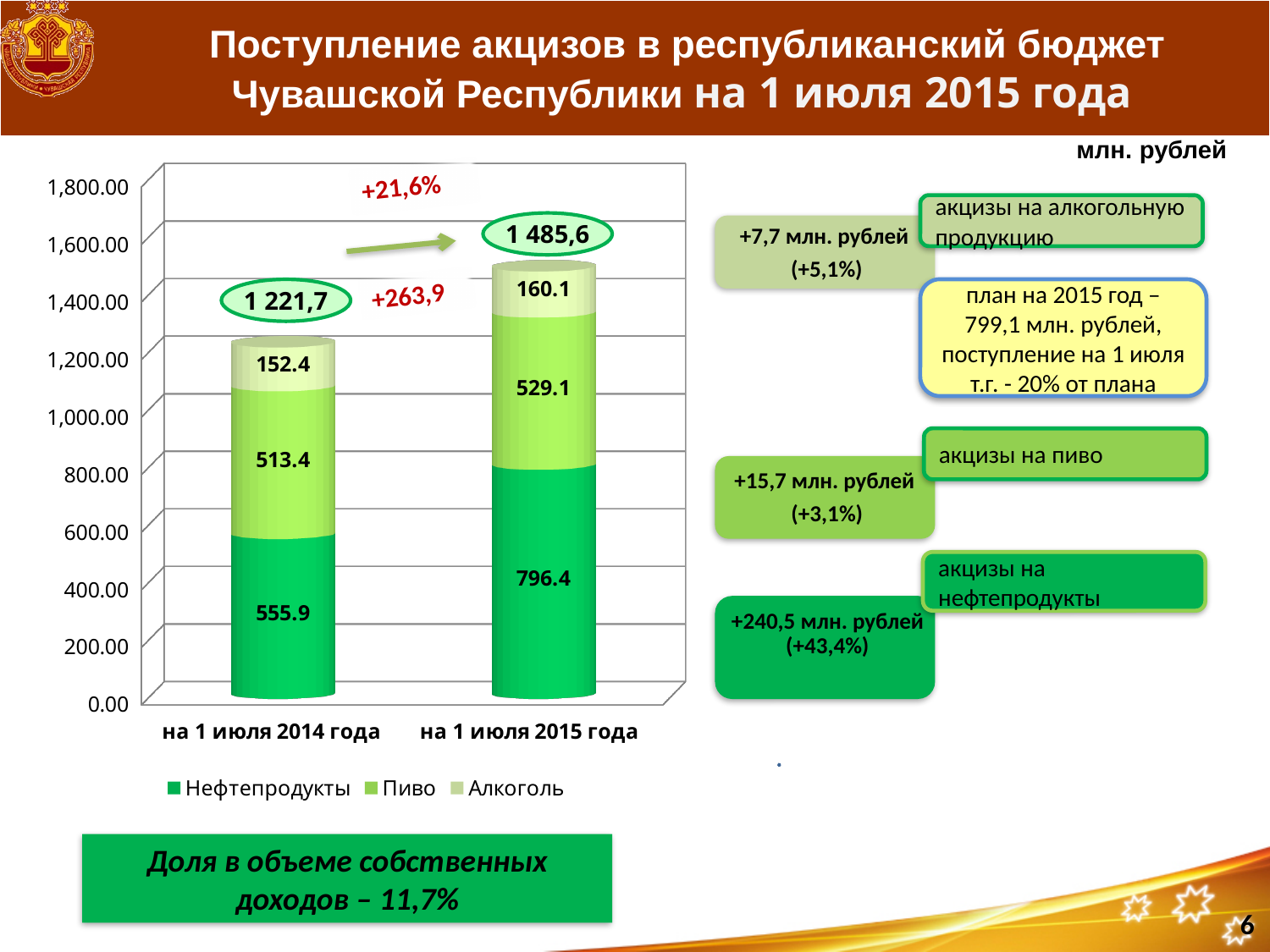
What is the difference between the Нефтепродукты values for 2015 and 2014? 240.5 Which is larger: Пиво on 1 July 2014 or Пиво on 1 July 2015? Пиво on 1 July 2015 Which series has the largest value in the bar for на 1 июля 2015 года? Нефтепродукты What is the total of the stacked bar for на 1 июля 2015 года, as labelled on the chart? 1 485,6 What is the value for Нефтепродукты on 1 July 2015 (на 1 июля 2015 года)? 796.4 Which series has the smallest value in the bar for на 1 июля 2014 года? Алкоголь How many series does the legend list? 3 What is the total of the stacked bar for на 1 июля 2014 года, as labelled on the chart? 1 221,7 How many categories are shown on the x axis? 2 What is the value for Алкоголь on 1 July 2015 (на 1 июля 2015 года)? 160.1 What kind of chart is shown on the slide? Stacked bar chart What is the value for Пиво on 1 July 2014 (на 1 июля 2014 года)? 513.4